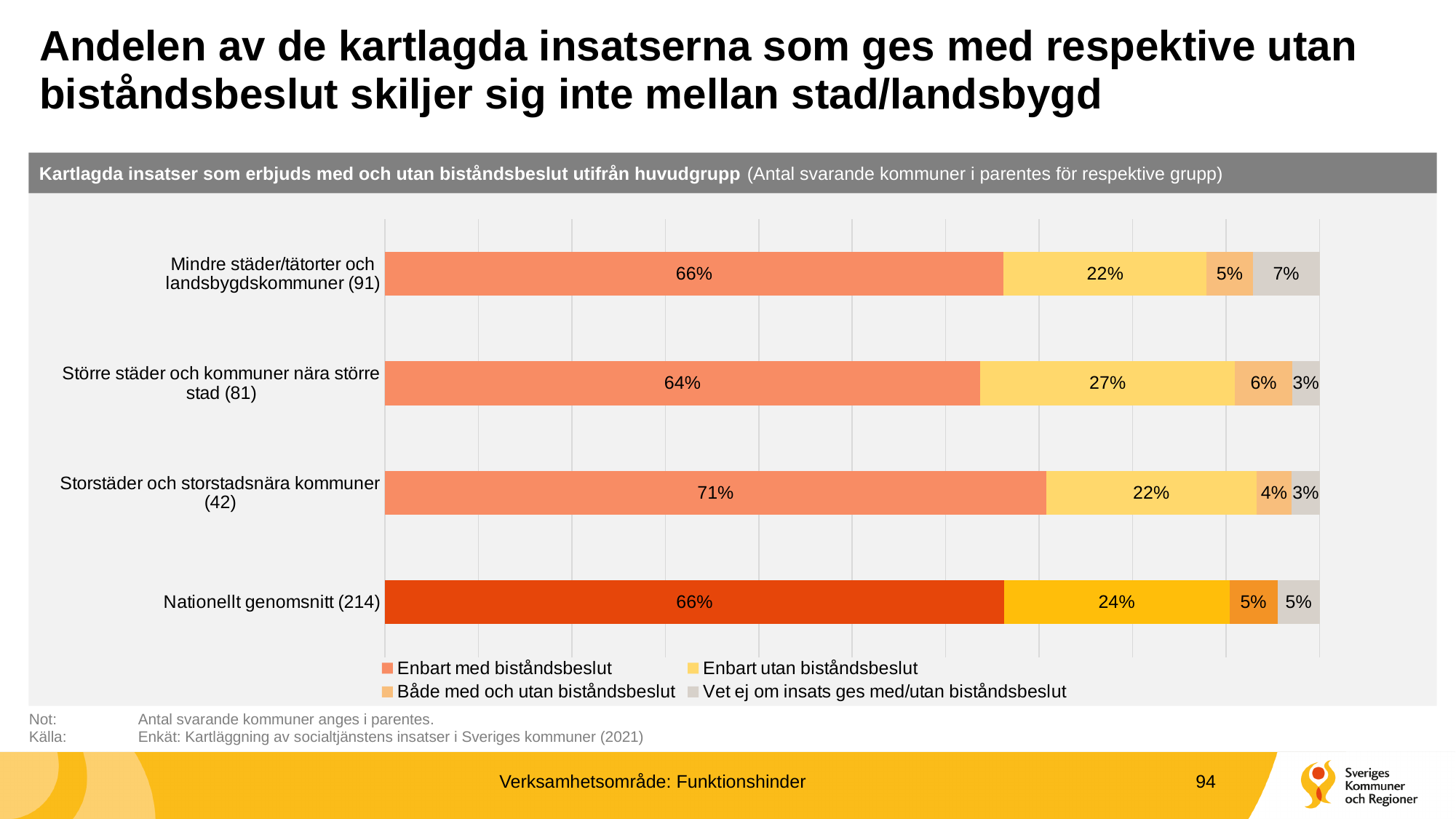
What is the value for "Enbart utan biståndsbeslut" for Större städer och kommuner nära större stad (81)? 27% What kind of chart is shown on the slide? Stacked bar chart How many series does the legend list? 4 Which legend entry is shown in the grey colour? Vet ej om insats ges med/utan biståndsbeslut What is the difference between the "Enbart utan biståndsbeslut" values for Större städer och kommuner nära större stad (81) and Storstäder och storstadsnära kommuner (42)? 5% Which category has the highest value for "Enbart med biståndsbeslut"? Storstäder och storstadsnära kommuner (42) What is the value for "Både med och utan biståndsbeslut" for Nationellt genomsnitt (214)? 5% What is the value for "Vet ej om insats ges med/utan biståndsbeslut" for Mindre städer/tätorter och landsbygdskommuner (91)? 7% Which category has the lowest value for "Enbart med biståndsbeslut"? Större städer och kommuner nära större stad (81) How many categories are shown on the chart? 4 Which is larger: the "Vet ej om insats ges med/utan biståndsbeslut" value for Mindre städer/tätorter och landsbygdskommuner (91) or for Nationellt genomsnitt (214)? Mindre städer/tätorter och landsbygdskommuner (91) What is the value for "Enbart med biståndsbeslut" for Storstäder och storstadsnära kommuner (42)? 71%